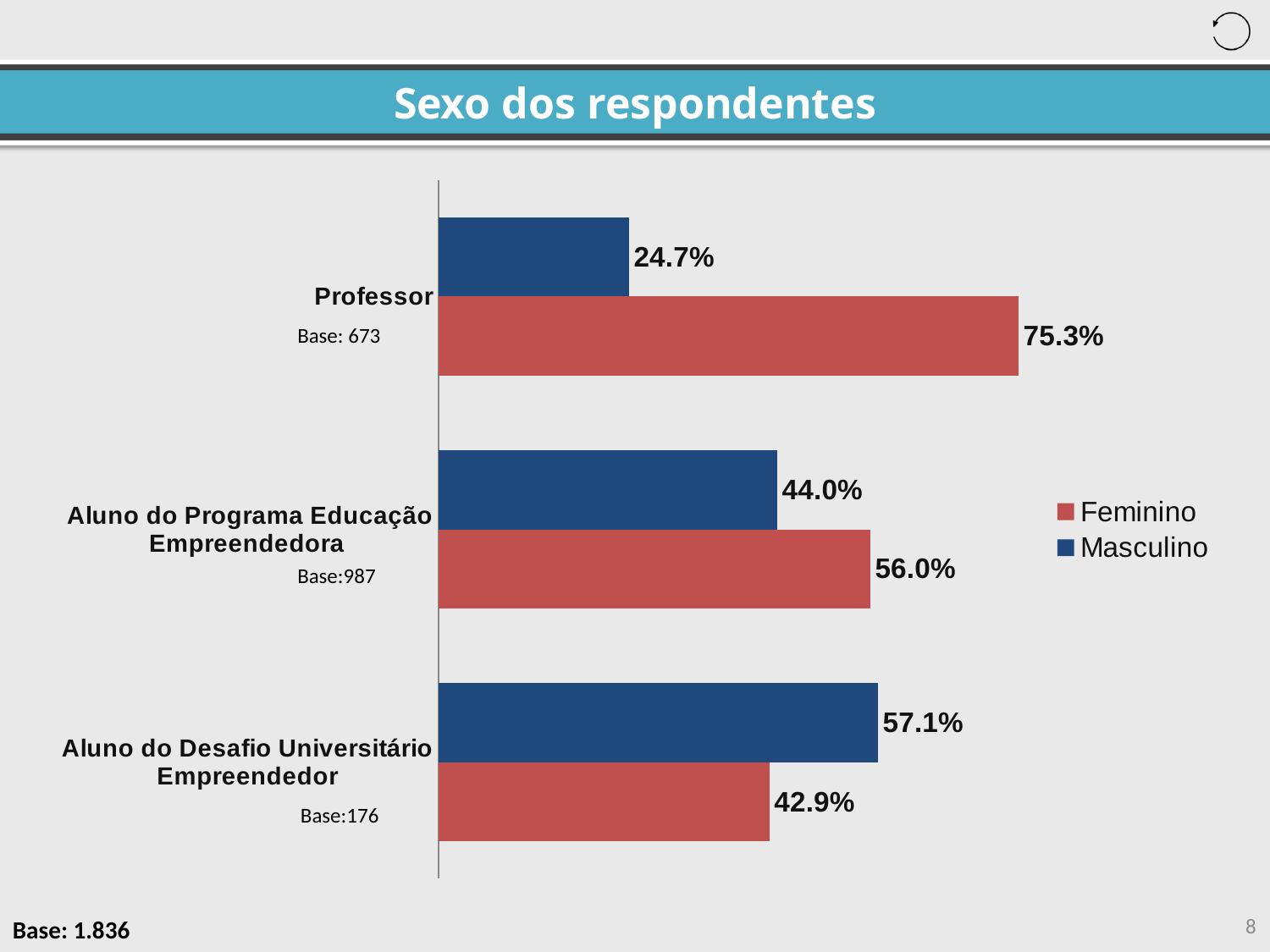
What is the Feminino value for Professor? 75.3% What is the Feminino value for Aluno do Programa Educação Empreendedora? 56.0% Which category has the highest Feminino value? Professor What is the title of the chart? Sexo dos respondentes What kind of chart is shown on the slide? Bar chart Which is larger for Aluno do Desafio Universitário Empreendedor, the Feminino or the Masculino value? Masculino How many series does the legend list? 2 What is the Masculino value for Aluno do Desafio Universitário Empreendedor? 57.1% What is the difference between the Feminino and Masculino values for Professor? 50.6% How many categories are shown on the chart? 3 Which colour represents the Feminino series? Red Which category has the lowest Masculino value? Professor